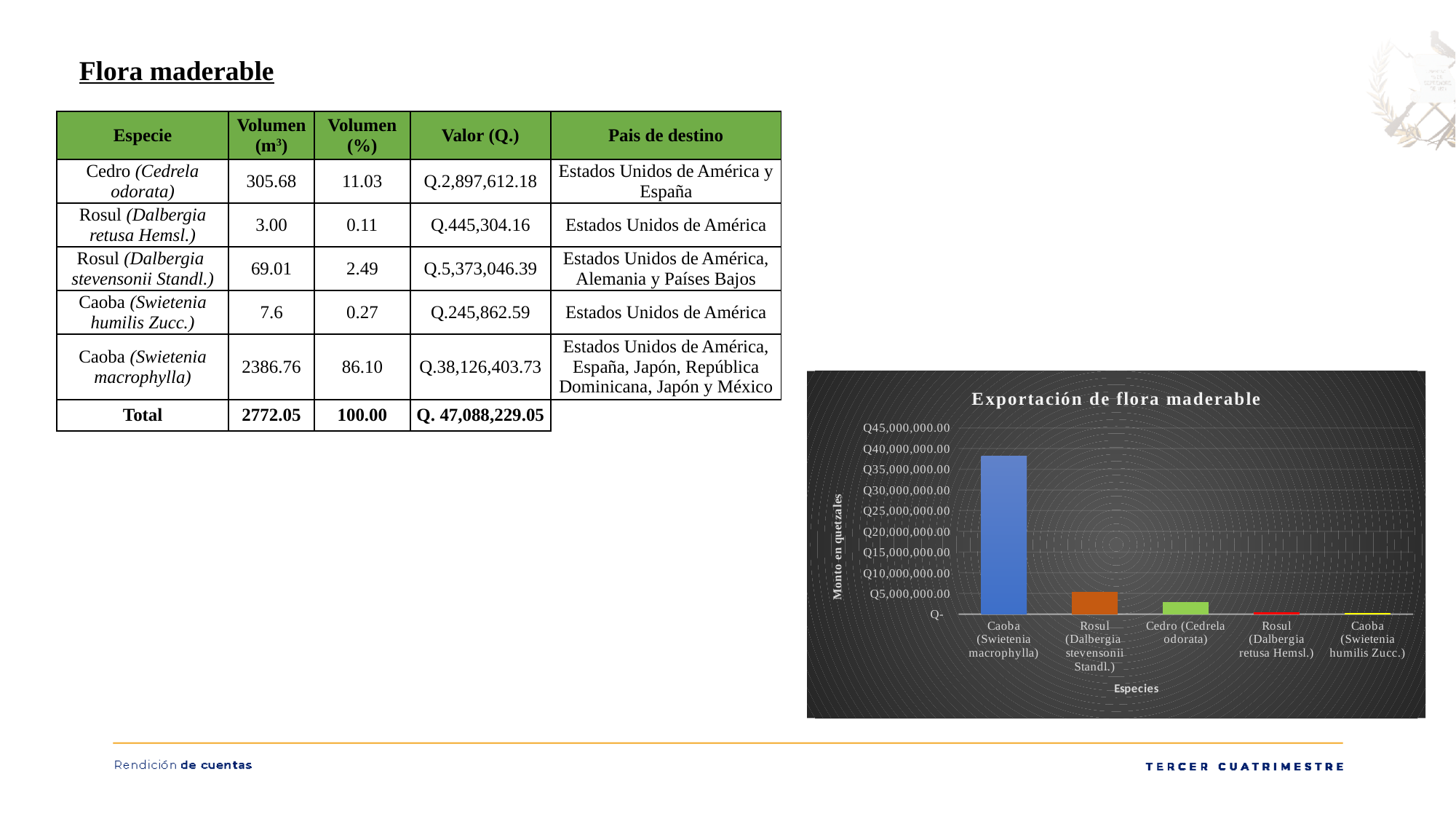
Is the value for Rosul (Dalbergia stevensonii Standl.) greater or less than Q10,000,000.00? less What is the title of the chart? Exportación de flora maderable What kind of chart is shown on the slide? bar chart Which has the larger value in the chart, Caoba (Swietenia macrophylla) or Rosul (Dalbergia stevensonii Standl.)? Caoba (Swietenia macrophylla) Is the value for Caoba (Swietenia macrophylla) greater or less than Q35,000,000.00? greater Which has the larger value in the chart, Rosul (Dalbergia stevensonii Standl.) or Cedro (Cedrela odorata)? Rosul (Dalbergia stevensonii Standl.) How many species (categories) are plotted in the chart? 5 Is the value for Caoba (Swietenia macrophylla) greater or less than Q40,000,000.00? less What is the label of the vertical axis of the chart? Monto en quetzales Which species has the highest bar in the chart? Caoba (Swietenia macrophylla)